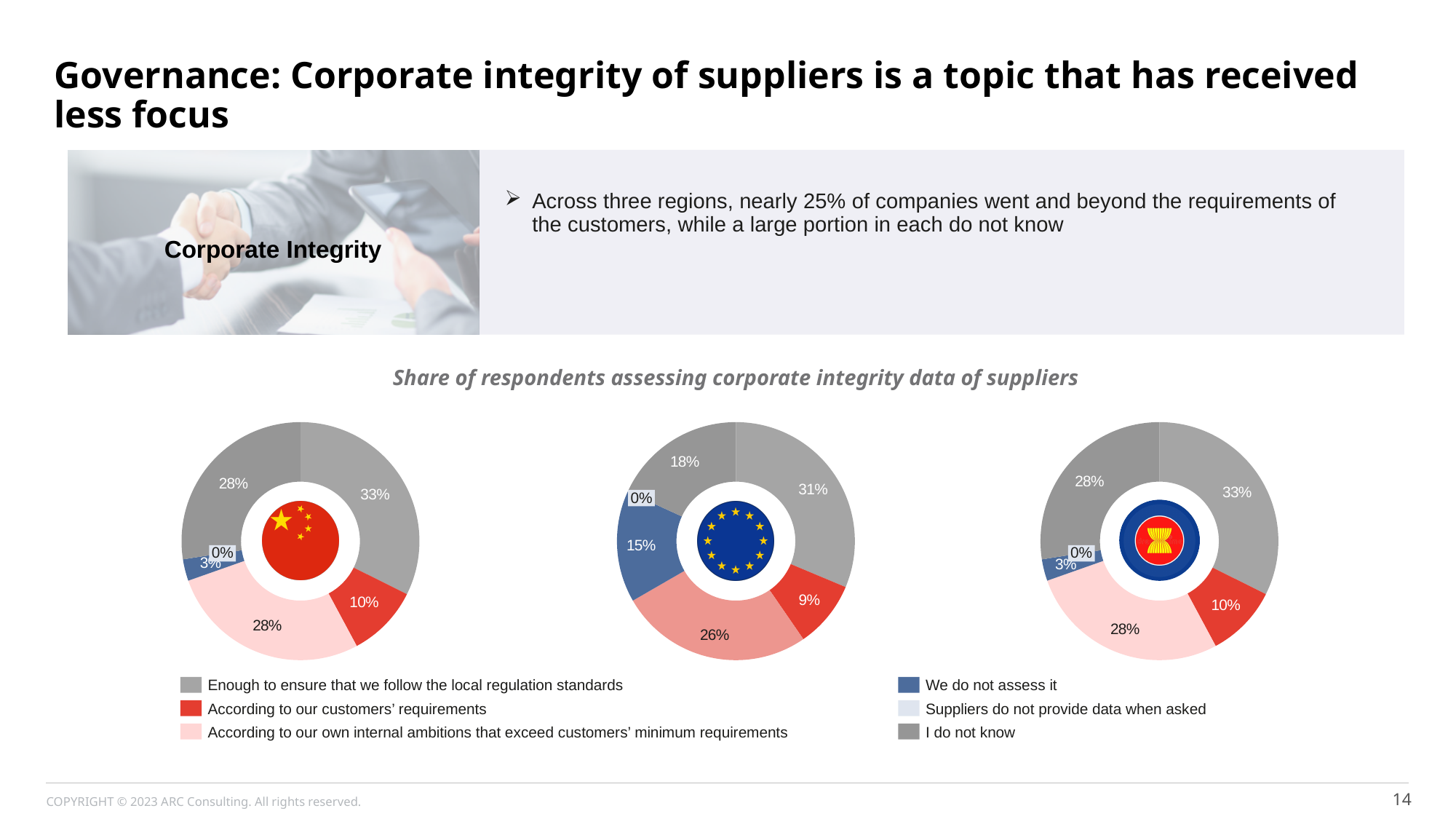
In the left donut chart (China flag), what share of respondents chose 'We do not assess it'? 3% In the middle donut chart (EU flag), what share of respondents chose 'We do not assess it'? 15% What is the title shown above the three donut charts? Share of respondents assessing corporate integrity data of suppliers In the middle donut chart (EU flag), which is larger: 'We do not assess it' or 'According to our customers' requirements'? We do not assess it In the middle donut chart (EU flag), what is the difference in percentage points between 'Enough to ensure that we follow the local regulation standards' and 'According to our customers' requirements'? 22 percentage points What kind of chart is used to show the share of respondents for each region? Pie (donut) chart In the middle donut chart (EU flag), what share of respondents chose 'I do not know'? 18% In the left donut chart (China flag), what share of respondents chose 'According to our customers' requirements'? 10% How many categories does the legend list for the donut charts? 6 In the middle donut chart (EU flag), which category has the smallest share? Suppliers do not provide data when asked In the middle donut chart (EU flag), which category has the largest share? Enough to ensure that we follow the local regulation standards In the right donut chart (ASEAN flag), what share of respondents chose 'According to our own internal ambitions that exceed customers' minimum requirements'? 28%